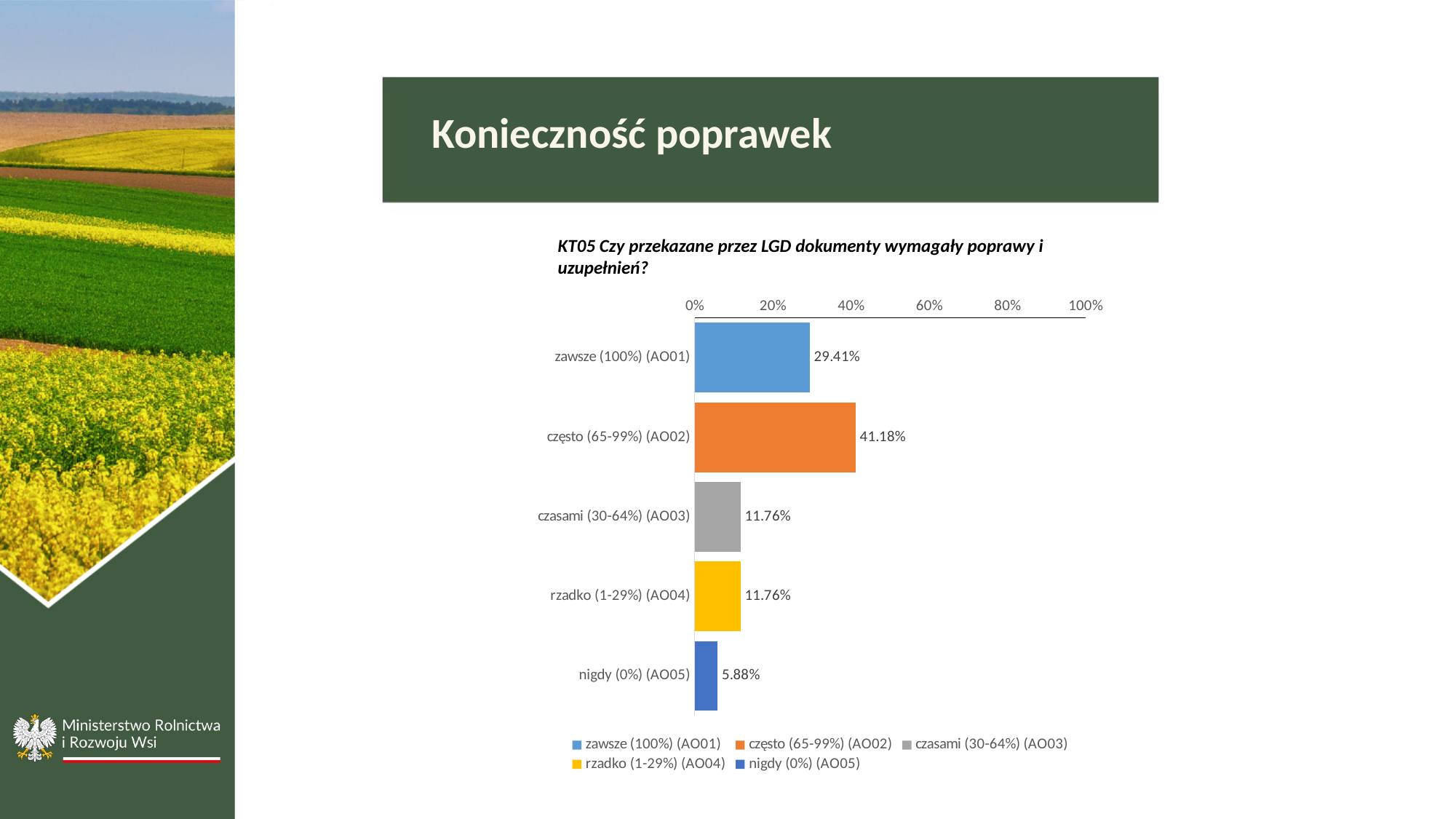
How many entries does the legend list? 5 What is the value for "zawsze (100%) (AO01)"? 29.41% Which category has the lowest value? nigdy (0%) (AO05) How many categories are shown in the chart? 5 What colour is the bar for "rzadko (1-29%) (AO04)"? yellow What is the value for "nigdy (0%) (AO05)"? 5.88% Which is larger, the value for "zawsze (100%) (AO01)" or the value for "czasami (30-64%) (AO03)"? zawsze (100%) (AO01) Is the value for "często (65-99%) (AO02)" greater or less than 40%? greater What is the difference between the values for "często (65-99%) (AO02)" and "zawsze (100%) (AO01)"? 11.77% What is the value for "często (65-99%) (AO02)"? 41.18% What kind of chart is shown on the slide? bar chart Which category has the highest value? często (65-99%) (AO02)